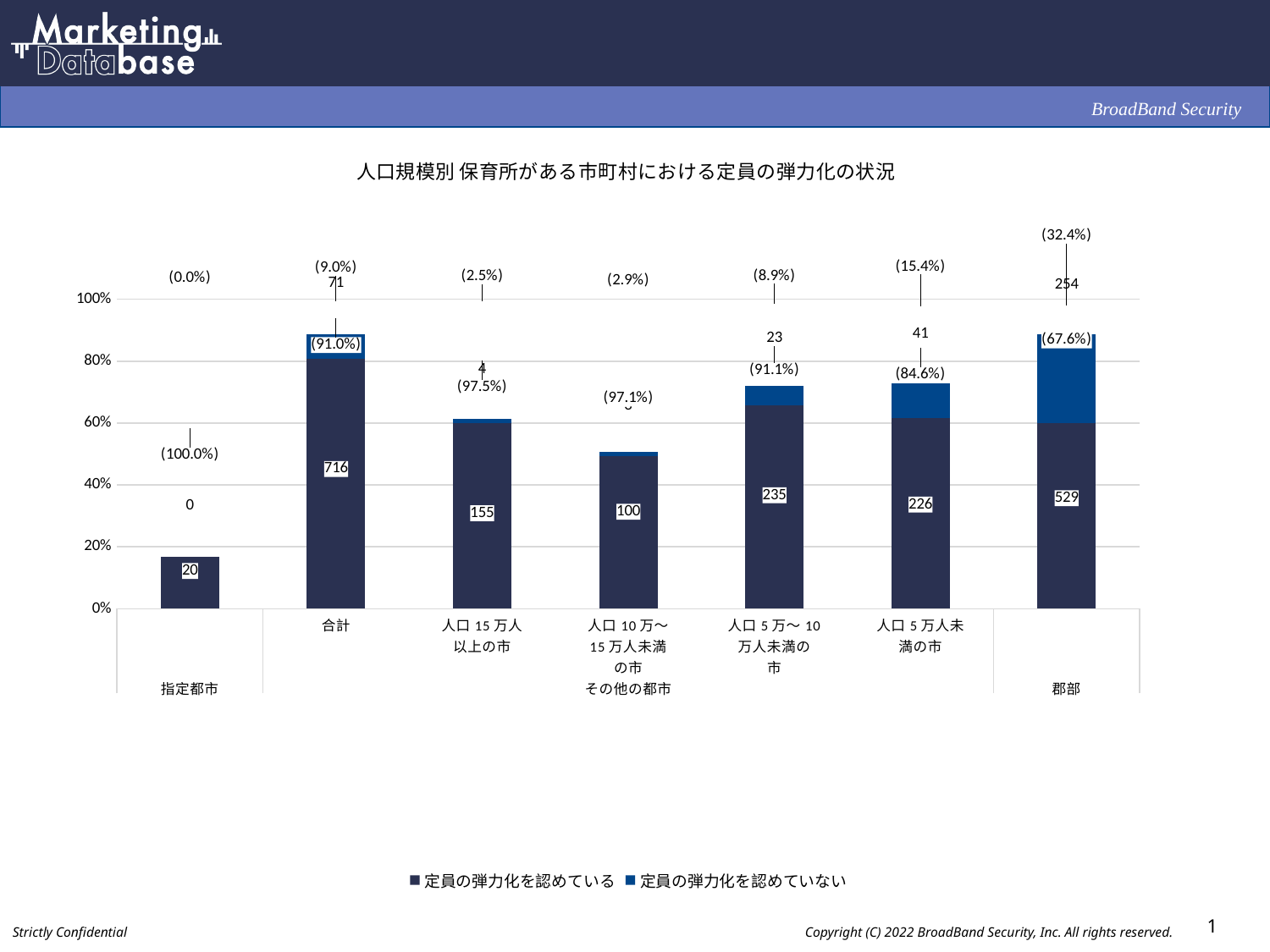
What is the total of the two series values in the 合計 category? 787 Which category has the lowest value for 定員の弾力化を認めていない? 指定都市 Which is larger, the 定員の弾力化を認めている value for 人口5万～10万人未満の市 or for 人口5万人未満の市? 人口5万～10万人未満の市 How many series does the legend list? 2 What is the difference between the 定員の弾力化を認めている value and the 定員の弾力化を認めていない value in the 郡部 category? 275 What kind of chart is shown on the slide? Stacked bar chart What is the value for 定員の弾力化を認めている in the 合計 category? 716 How many categories are shown on the x axis of the chart? 7 What percentage is shown for 定員の弾力化を認めている in the 人口5万人未満の市 category? 84.6% What is the value for 定員の弾力化を認めていない in the 郡部 category? 254 What percentage is shown for 定員の弾力化を認めていない in the 指定都市 category? 0.0% Which category has the highest value for 定員の弾力化を認めている? 合計